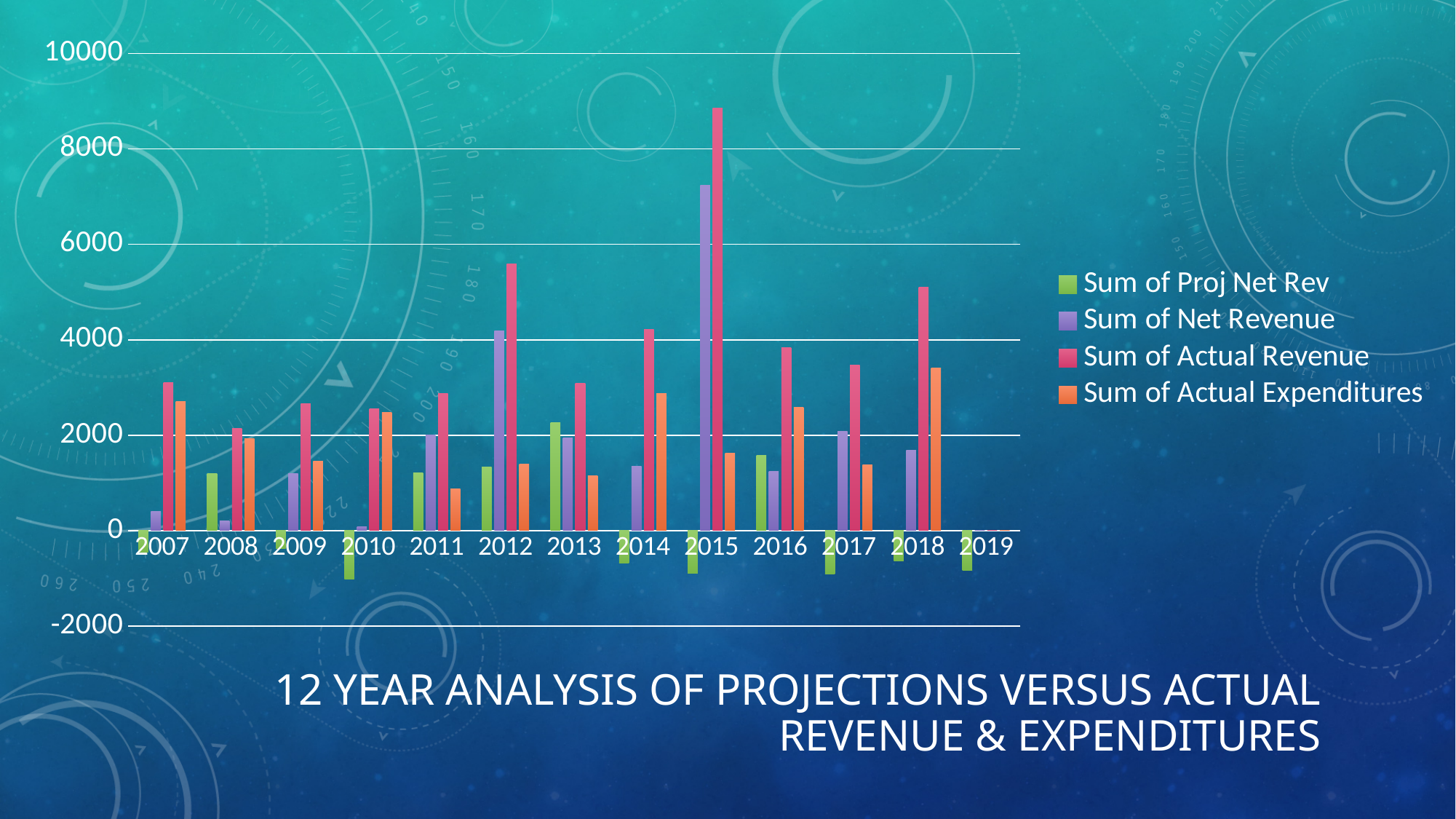
Which year has the highest Sum of Actual Revenue? 2015 For 2011, which is larger, the Sum of Net Revenue or the Sum of Actual Expenditures? Sum of Net Revenue Which is larger, the Sum of Actual Revenue for 2012 or for 2014? 2012 Which year has the highest Sum of Proj Net Rev? 2013 How many series does the legend list? 4 What kind of chart is shown on the slide? Bar chart Is the Sum of Actual Expenditures for 2018 greater or less than 4000? less Is the Sum of Actual Revenue for 2015 greater or less than 8000? greater What is the title of the chart? 12 Year Analysis of Projections Versus Actual Revenue & Expenditures Is the Sum of Net Revenue for 2015 greater or less than 6000? greater How many years are shown along the x axis? 13